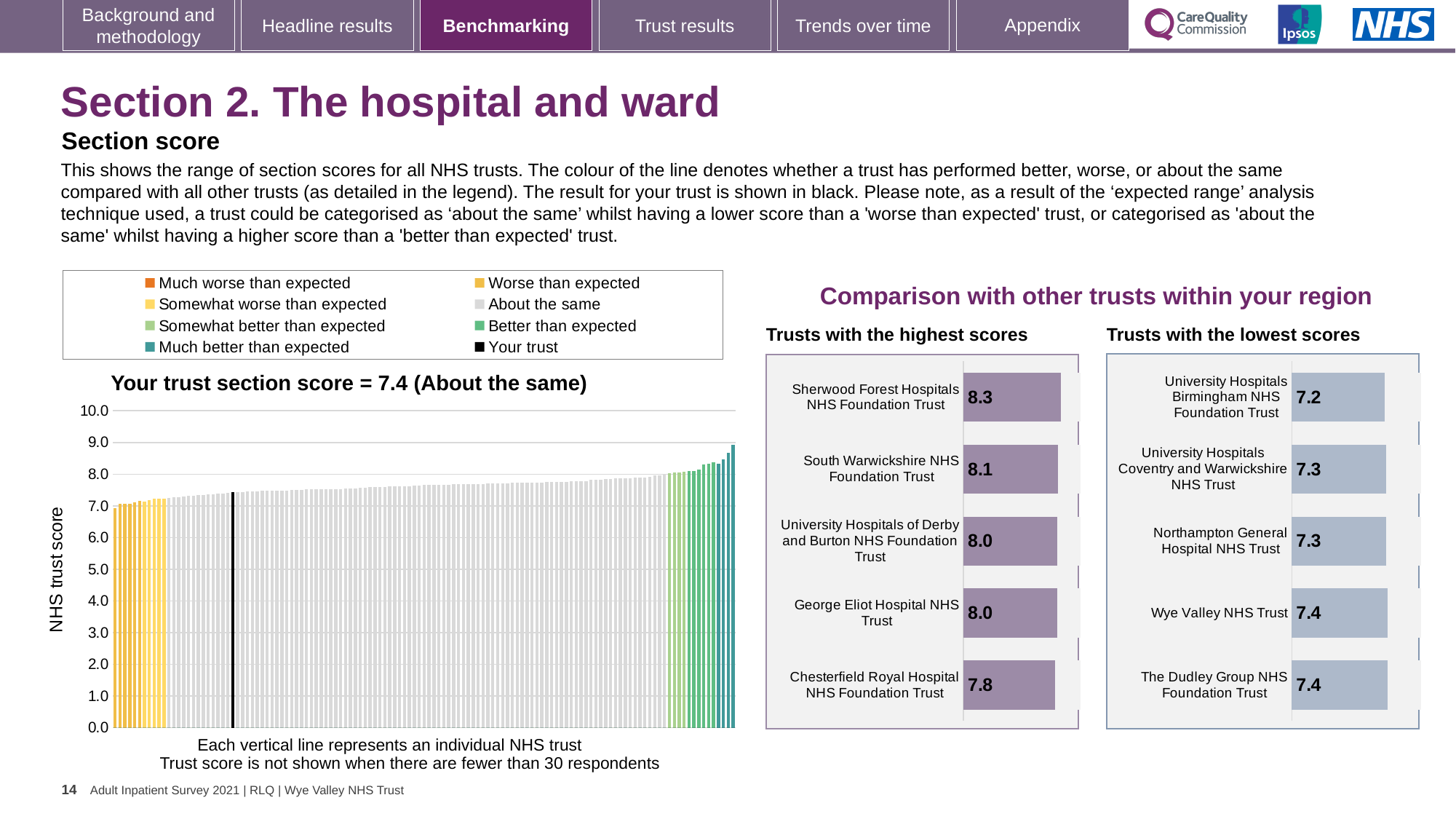
What kind of chart is the 'Your trust section score' chart? Bar chart In the 'Trusts with the lowest scores' chart, how many trusts are shown? 5 In the 'Your trust section score' chart, what colour is the bar for your trust? Black In the 'Your trust section score' chart, is the value of the highest bar greater or less than 8.0? greater In the 'Your trust section score' chart, what is the section score for your trust? 7.4 In the 'Trusts with the highest scores' chart, what is the difference between the scores of Sherwood Forest Hospitals NHS Foundation Trust and Chesterfield Royal Hospital NHS Foundation Trust? 0.5 In the 'Trusts with the lowest scores' chart, which trust has the lowest score? University Hospitals Birmingham NHS Foundation Trust In the 'Your trust section score' chart, do the trust scores rise or fall from left to right along the x axis? Rise In the 'Trusts with the highest scores' chart, which trust has the lowest score? Chesterfield Royal Hospital NHS Foundation Trust In the 'Trusts with the lowest scores' chart, what is the score for Northampton General Hospital NHS Trust? 7.3 In the 'Trusts with the highest scores' chart, what is the score for Sherwood Forest Hospitals NHS Foundation Trust? 8.3 In the 'Your trust section score' chart, how many categories does the legend list? 8